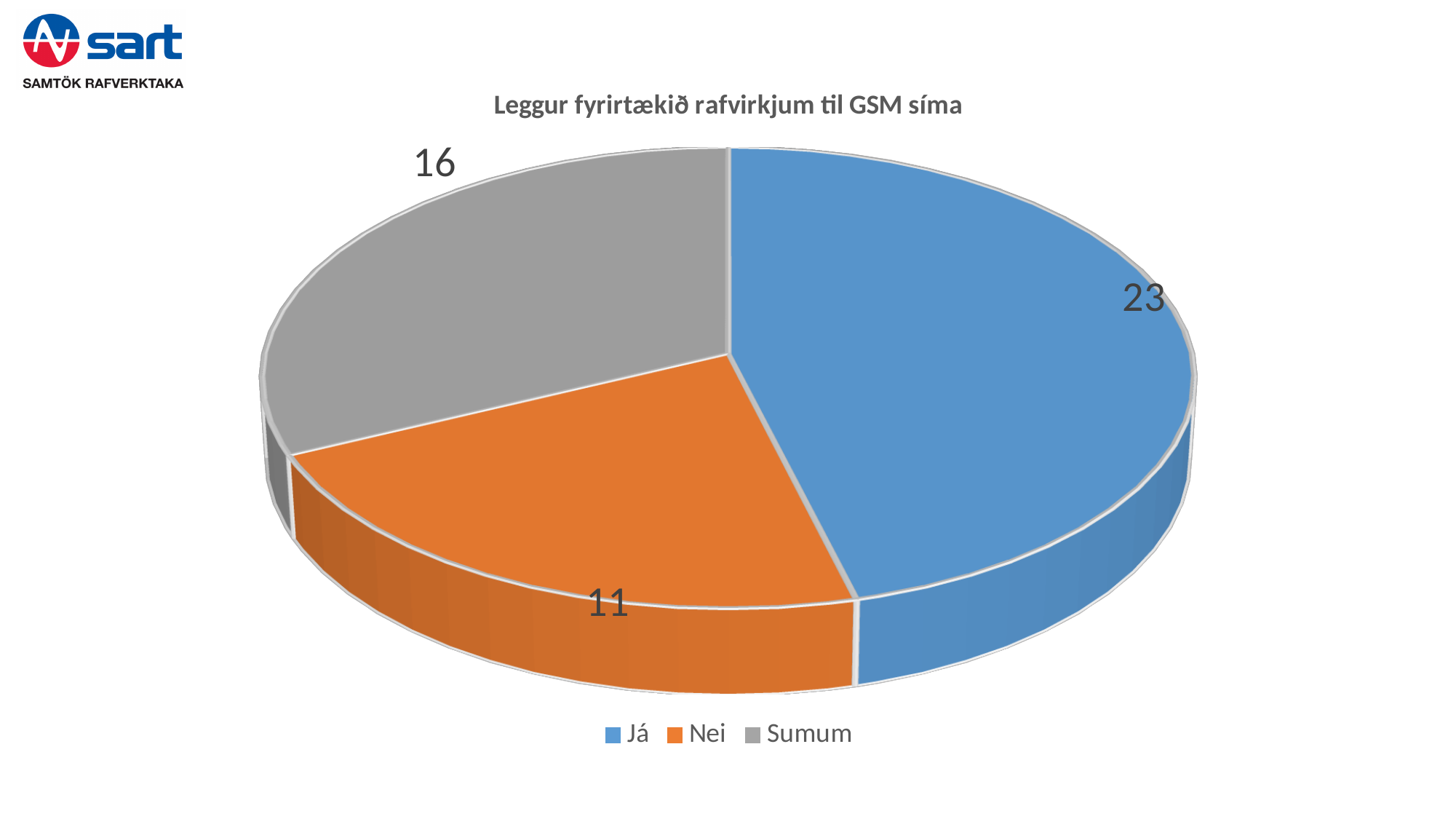
What is the value for Sumum? 16 Which category has the smallest slice? Nei What is the title of the chart? Leggur fyrirtækið rafvirkjum til GSM síma What is the difference between the values for Já and Nei? 12 What is the difference between the values for Sumum and Nei? 5 What kind of chart is shown on the slide? Pie chart How many slices does the pie chart have? 3 What is the value for Nei? 11 What is the value for Já? 23 Which is larger, the value for Sumum or the value for Nei? Sumum Which category has the largest slice? Já